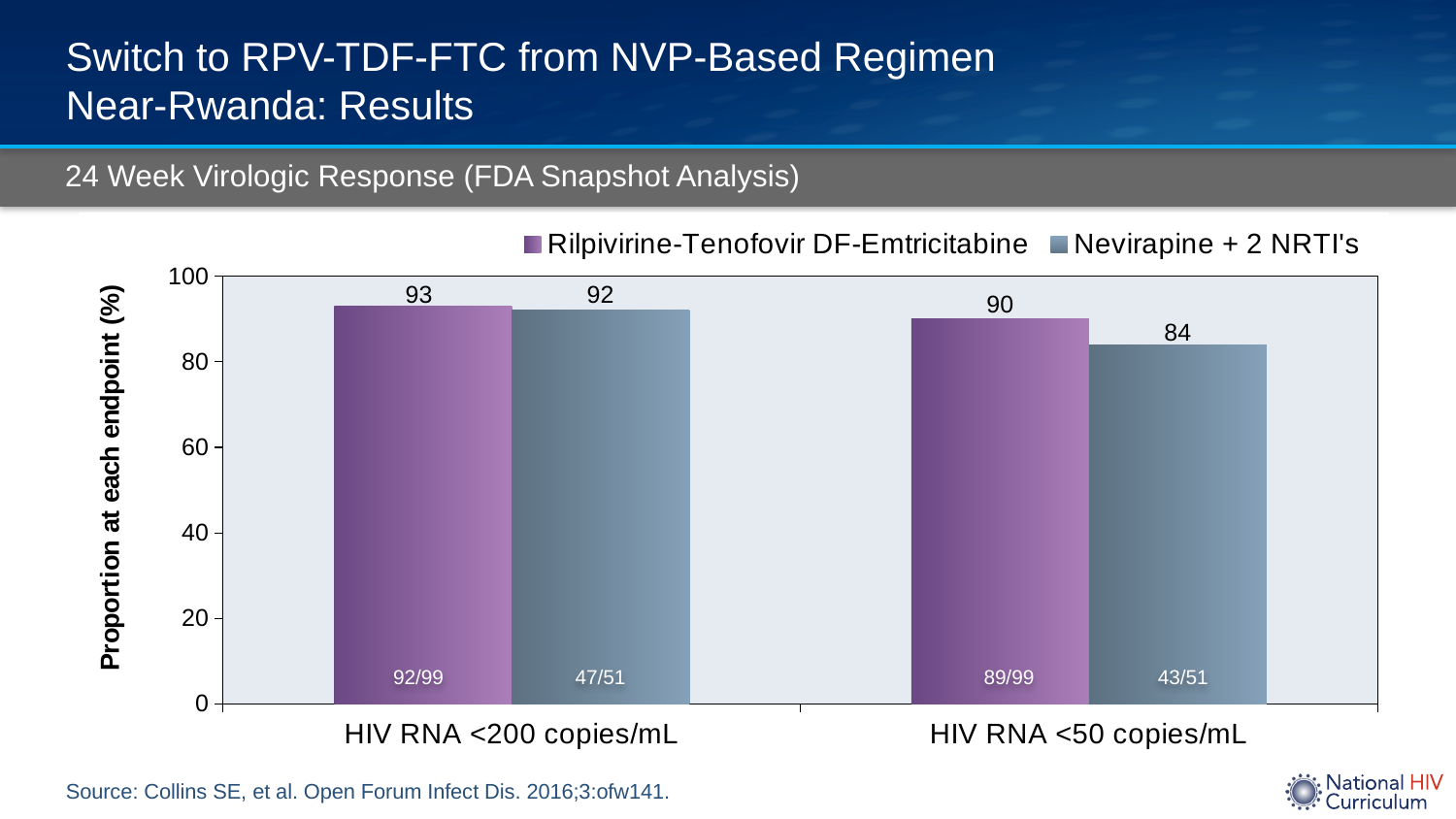
Which bar has the lowest value on the chart? Nevirapine + 2 NRTI's, HIV RNA <50 copies/mL How many series does the legend list? 2 What is the value for Nevirapine + 2 NRTI's in the HIV RNA <200 copies/mL category? 92 What is the value for Rilpivirine-Tenofovir DF-Emtricitabine in the HIV RNA <200 copies/mL category? 93 What is the difference between the Rilpivirine-Tenofovir DF-Emtricitabine values for HIV RNA <200 copies/mL and HIV RNA <50 copies/mL? 3 In the HIV RNA <50 copies/mL category, which series has the larger value? Rilpivirine-Tenofovir DF-Emtricitabine What is the value for Nevirapine + 2 NRTI's in the HIV RNA <50 copies/mL category? 84 How many categories are shown on the x axis? 2 What is the difference between the Rilpivirine-Tenofovir DF-Emtricitabine and Nevirapine + 2 NRTI's values in the HIV RNA <50 copies/mL category? 6 Is the value for Nevirapine + 2 NRTI's in the HIV RNA <50 copies/mL category greater or less than 80? greater What fraction is printed inside the Rilpivirine-Tenofovir DF-Emtricitabine bar for HIV RNA <50 copies/mL? 89/99 What type of chart is shown on the slide? Bar chart